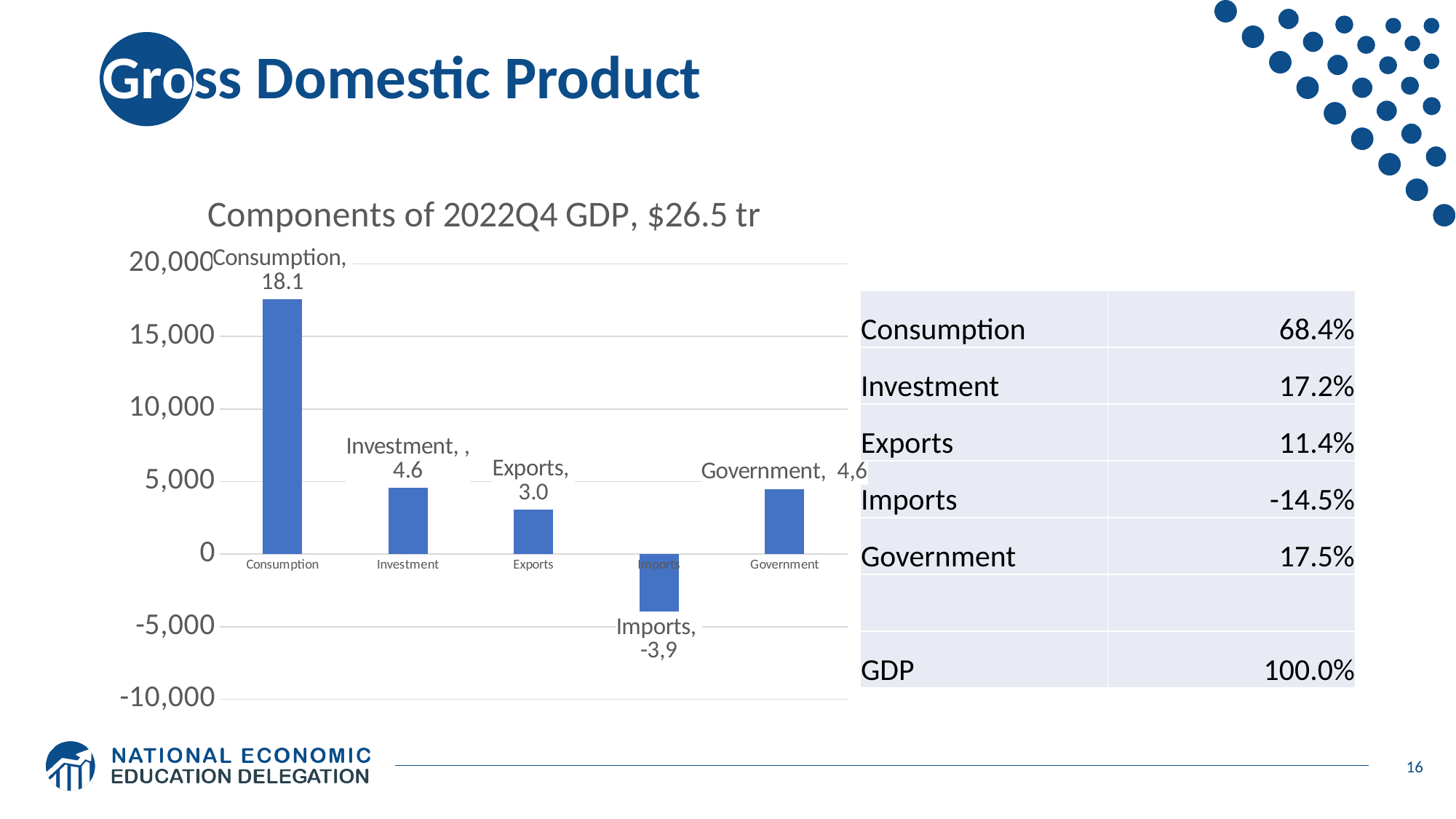
What is the data label value for Investment in the chart? 4.6 Which category has the highest bar in the chart? Consumption What is the title of the chart? Components of 2022Q4 GDP, $26.5 tr How many categories are shown on the x axis of the chart? 5 Is the value for Consumption greater or less than 15,000 on the axis? greater What is the data label value for Exports in the chart? 3.0 What is the data label value for Consumption in the chart? 18.1 Is the value for Imports greater or less than 0 on the axis? less Which category has the lowest bar in the chart? Imports What is the difference between the data label values for Consumption and Exports? 15.1 Which is larger, the bar for Consumption or the bar for Exports? Consumption What is the data label value for Imports in the chart? -3,9